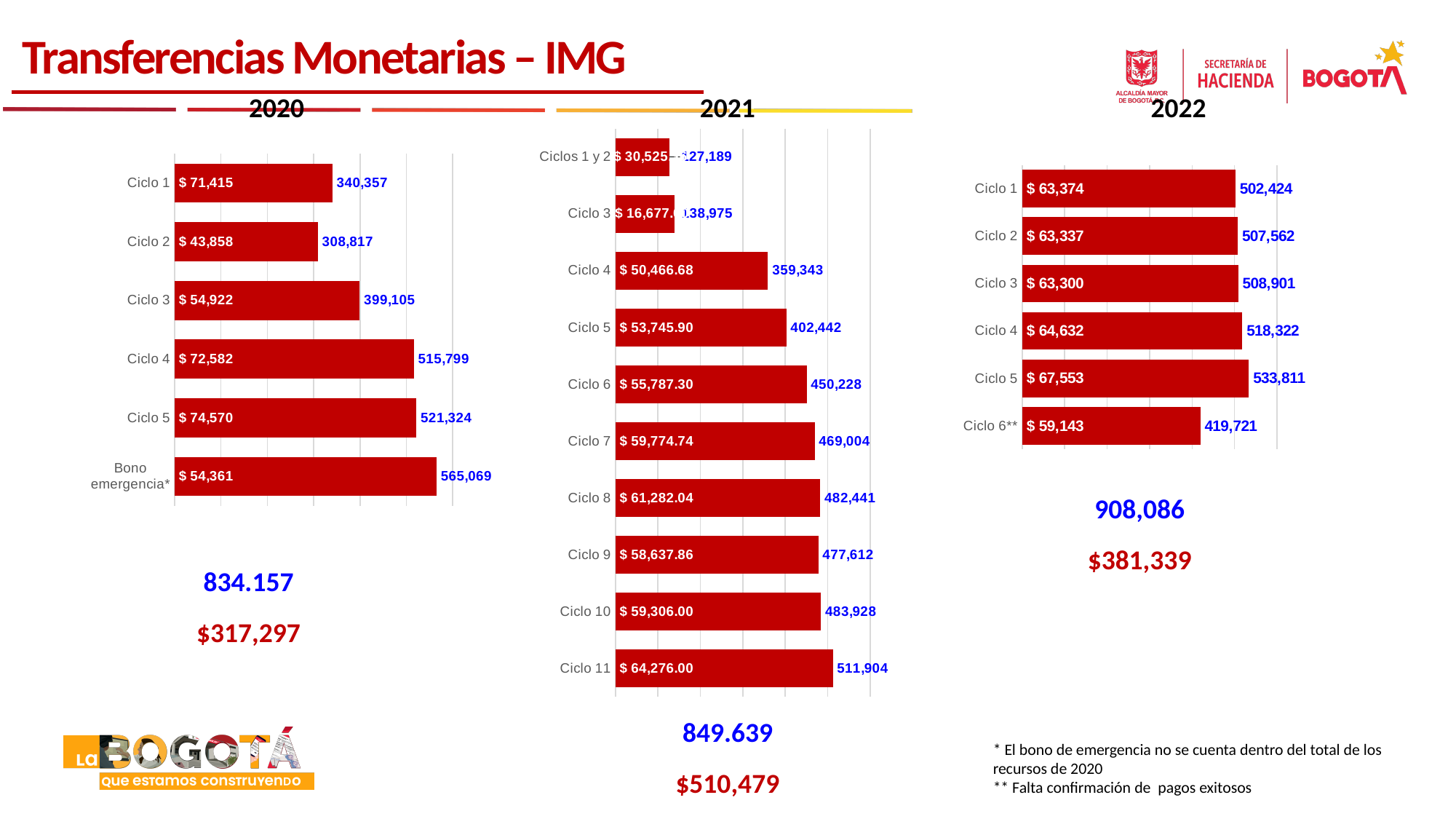
In the 2020 chart, what is the blue value shown next to the bar for Ciclo 4? 515,799 In the 2021 chart, what dollar amount is printed inside the bar for Ciclo 11? $ 64,276.00 In the 2022 chart, what is the difference between the blue values for Ciclo 5 and Ciclo 6**? 114,090 In the 2021 chart, how many categories are plotted? 10 In the 2020 chart, which category has the shortest bar? Ciclo 2 In the 2022 chart, which bar is longer, Ciclo 1 or Ciclo 4? Ciclo 4 In the 2020 chart, which category has the longest bar? Bono emergencia* In the 2022 chart, what is the blue value shown next to the bar for Ciclo 5? 533,811 In the 2020 chart, what dollar amount is printed inside the bar for Ciclo 2? $ 43,858 In the 2021 chart, what is the blue value shown next to the bar for Ciclo 8? 482,441 What type of chart is used for the 2022 data? Bar chart In the 2021 chart, which category has the longest bar? Ciclo 11